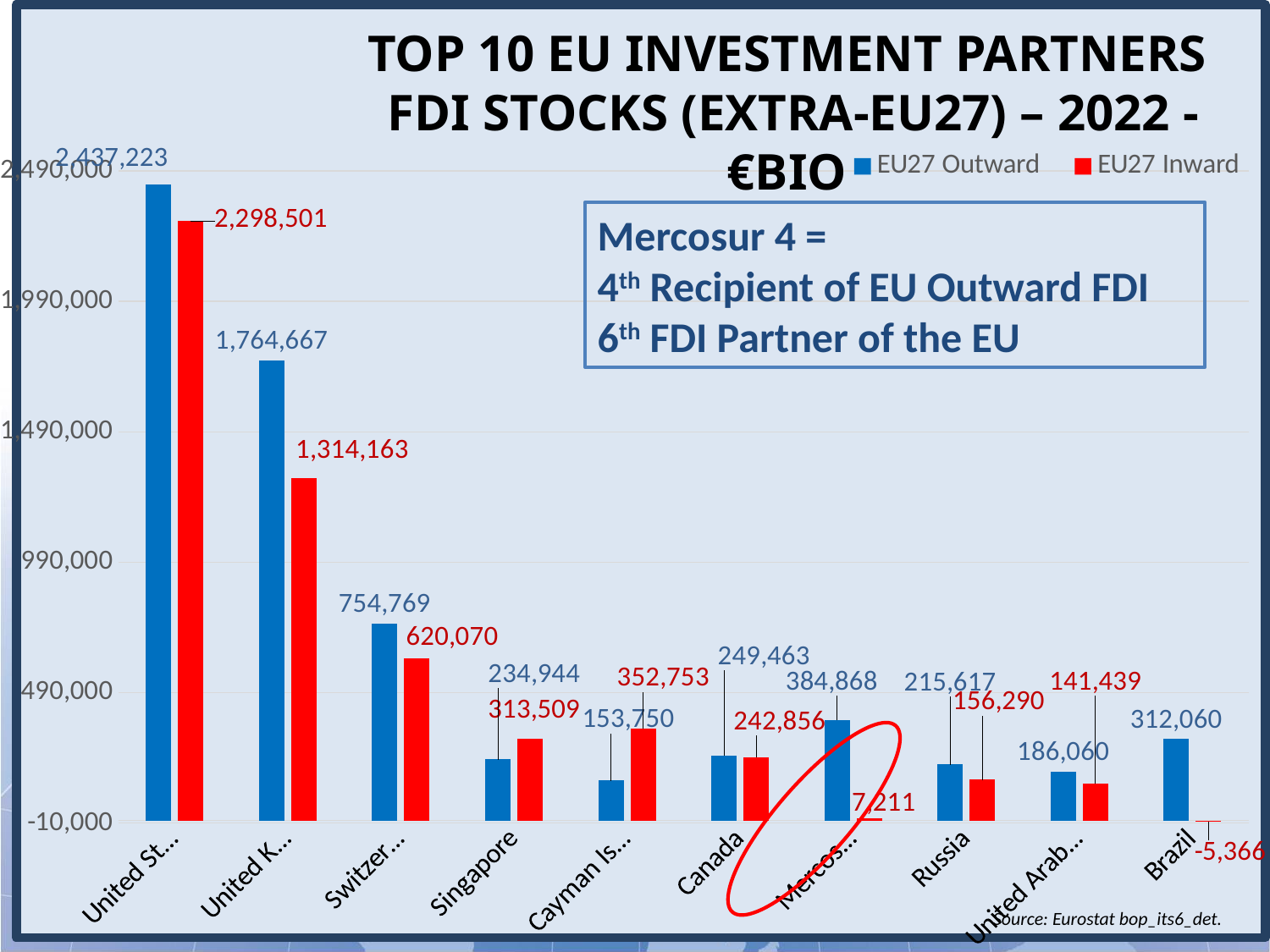
Is the EU27 Outward value for Brazil greater or less than 490,000? less What is the EU27 Outward value for Russia? 215,617 How many categories (investment partners) are shown on the x axis? 10 Which category has the highest EU27 Outward value? United States What is the EU27 Outward value for Singapore? 234,944 What kind of chart is shown on the slide? bar chart What is the EU27 Inward value for Canada? 242,856 What is the EU27 Inward value for Brazil? -5,366 Which category has the lowest EU27 Inward value? Brazil How many series does the legend list? 2 For Singapore, which is larger: EU27 Outward or EU27 Inward? EU27 Inward What is the difference between the EU27 Outward and EU27 Inward values for Russia? 59,327